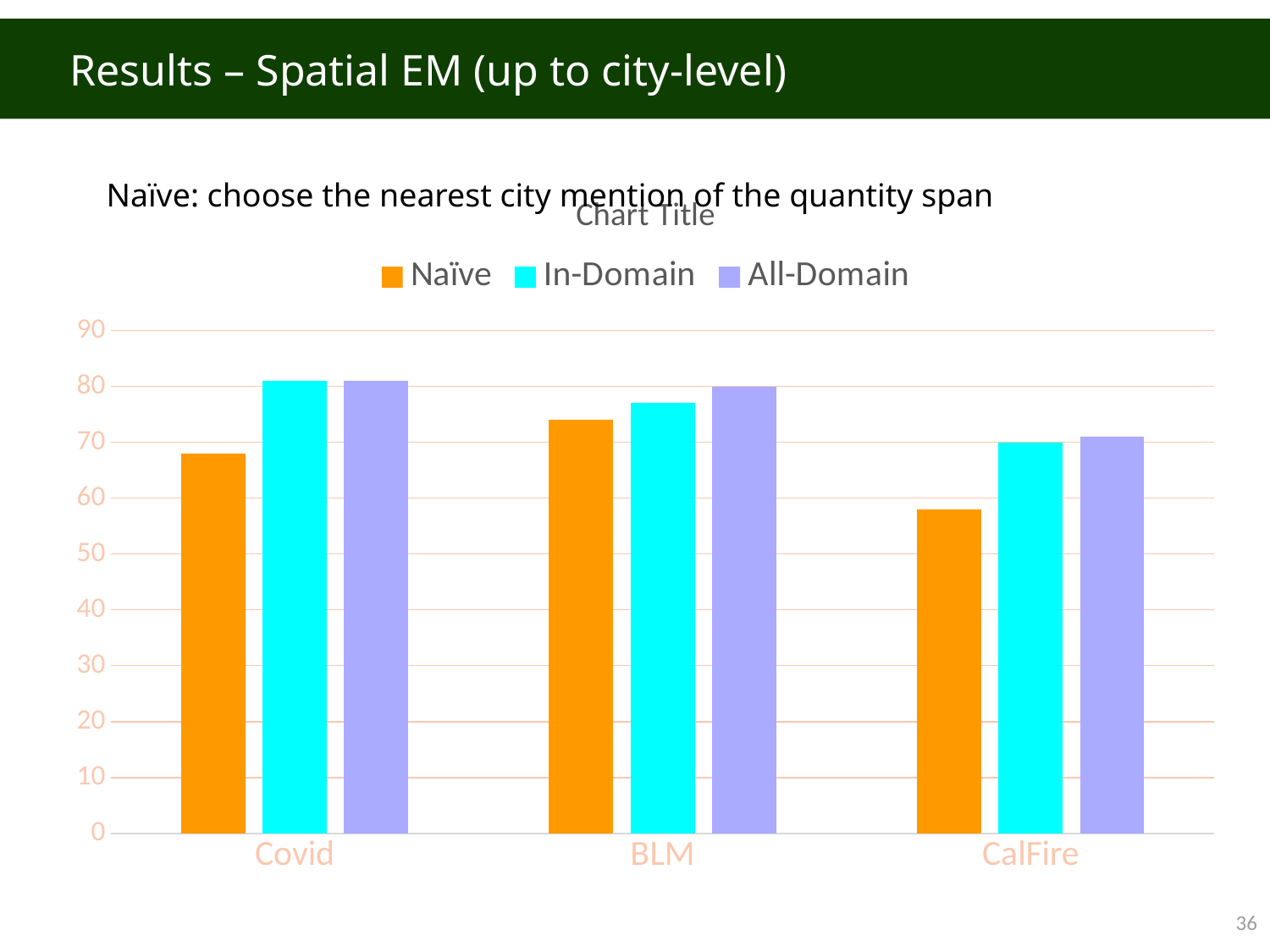
How many series does the legend list? 3 Is the Naïve value for CalFire greater or less than 60? less How many categories are shown on the x axis? 3 What title is displayed above the chart's legend? Chart Title Is the Naïve value for BLM greater or less than 70? greater Is the Naïve value for Covid greater or less than 70? less Which is larger, the Naïve value for Covid or the Naïve value for BLM? BLM What kind of chart is shown on the slide? bar chart What are the three series named in the legend? Naïve, In-Domain, All-Domain For CalFire, which is larger, the Naïve value or the In-Domain value? In-Domain For which category is the Naïve value lowest? CalFire